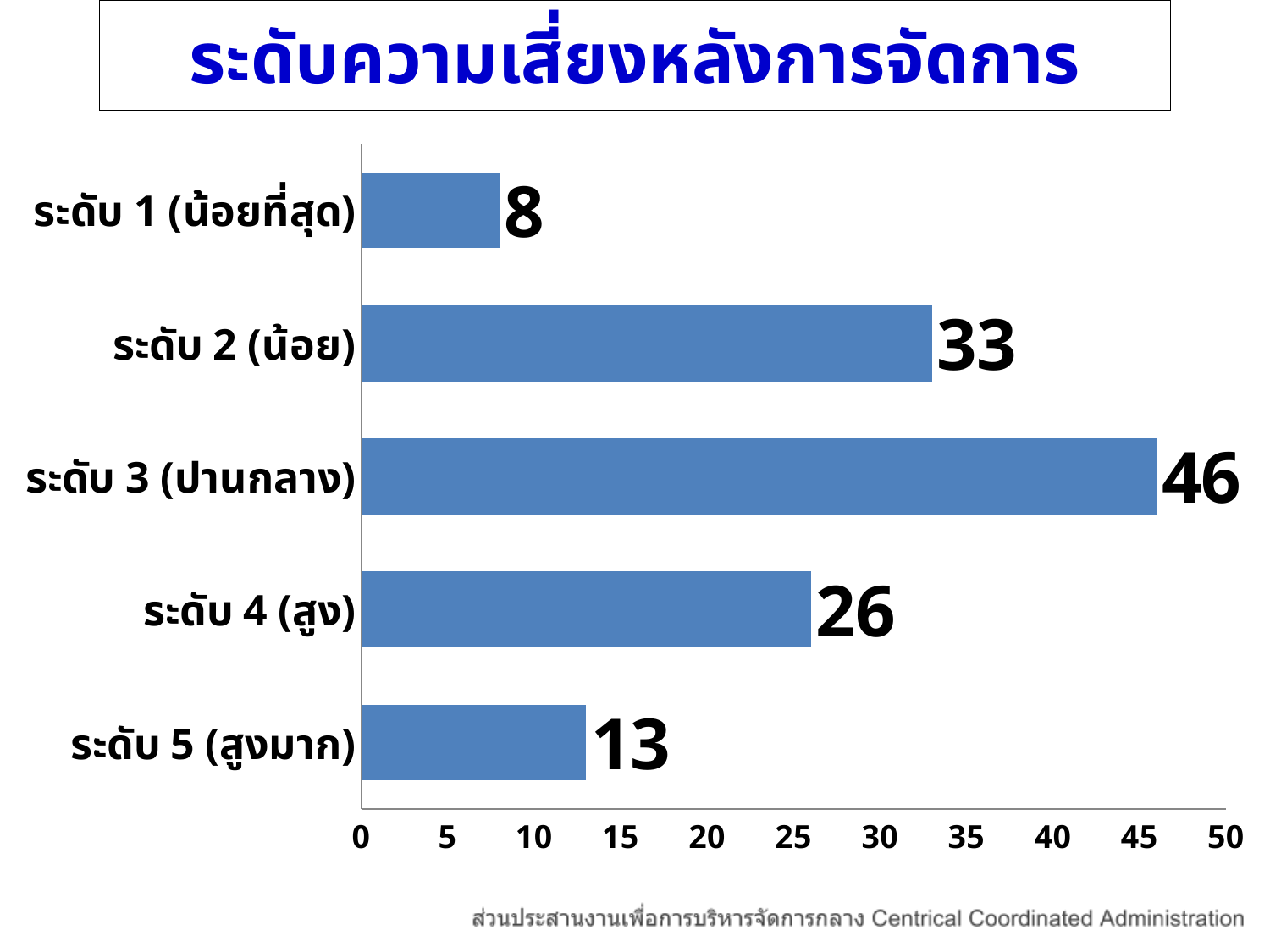
What is the maximum value shown on the x axis? 50 Which category has the lowest value? ระดับ 1 (น้อยที่สุด) Which is larger, the value for ระดับ 4 (สูง) or the value for ระดับ 5 (สูงมาก)? ระดับ 4 (สูง) Is the value for ระดับ 2 (น้อย) greater or less than 30? greater What is the value for ระดับ 1 (น้อยที่สุด)? 8 What is the difference between the values for ระดับ 2 (น้อย) and ระดับ 4 (สูง)? 7 What is the value for ระดับ 5 (สูงมาก)? 13 Which category has the highest value? ระดับ 3 (ปานกลาง) What kind of chart is shown on the slide? bar chart What is the value for ระดับ 3 (ปานกลาง)? 46 What is the title of the chart? ระดับความเสี่ยงหลังการจัดการ How many categories are shown in the chart? 5